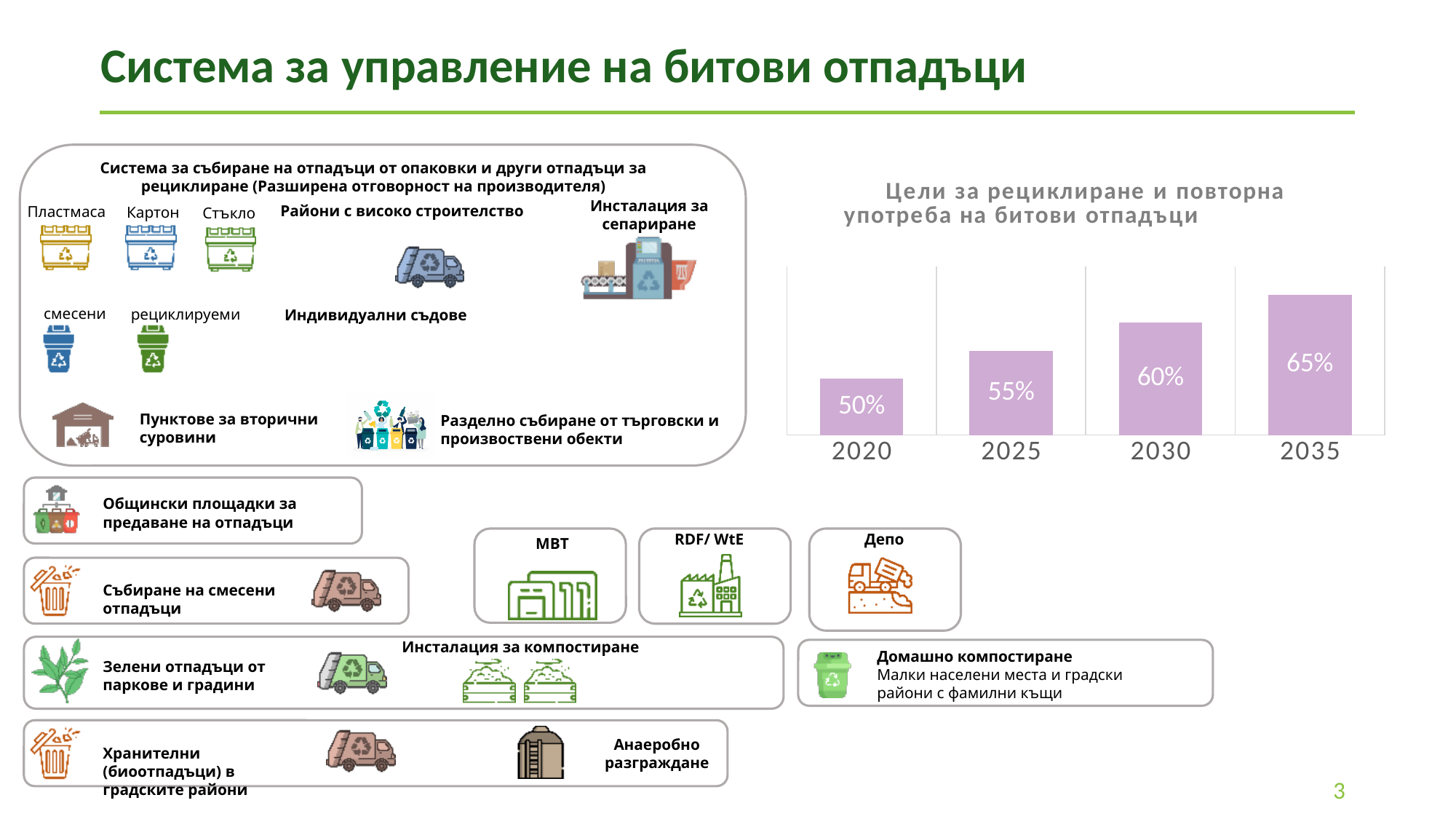
Which year has the lowest recycling target? 2020 Which is larger, the target for 2025 or the target for 2030? 2030 What is the recycling target for 2030? 60% What kind of chart is used to show the recycling targets? Bar chart What is the recycling target for 2020? 50% How many years are shown on the chart? 4 What is the recycling target for 2025? 55% What is the recycling target for 2035? 65% What is the difference between the 2035 target and the 2020 target? 15% Do the recycling targets rise or fall from 2020 to 2035? Rise What is the difference between the 2030 target and the 2025 target? 5% Which year has the highest recycling target? 2035